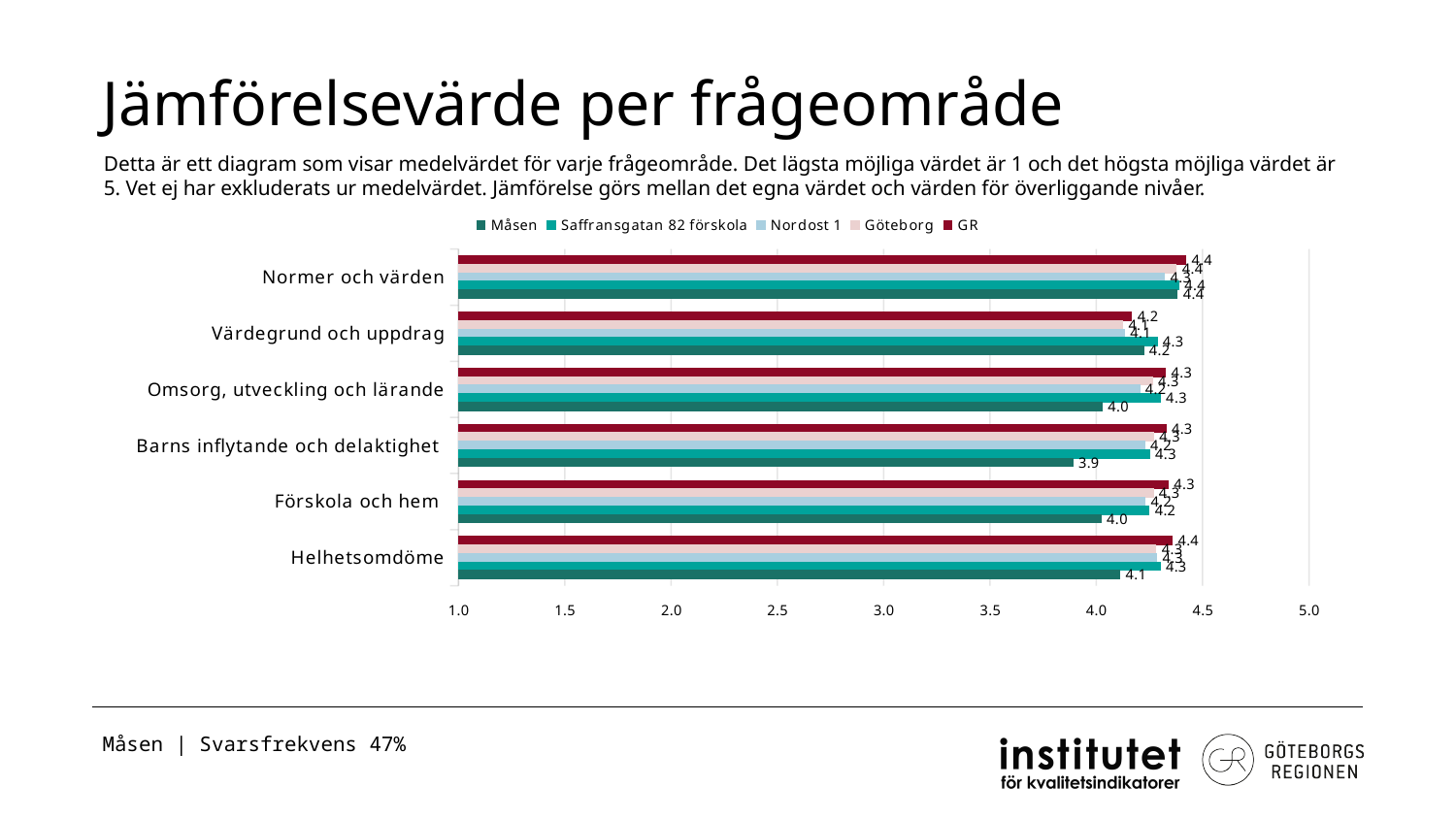
What is the value for Måsen in 'Barns inflytande och delaktighet'? 3.9 Which is larger for 'Omsorg, utveckling och lärande': the value for Måsen or the value for Saffransgatan 82 förskola? Saffransgatan 82 förskola Which series is shown in dark red in the legend? GR How many question areas (categories) are shown on the y axis? 6 Is the value for Måsen in 'Barns inflytande och delaktighet' greater or less than 4.0? less What is the difference between Saffransgatan 82 förskola and Måsen in 'Barns inflytande och delaktighet'? 0.4 What type of chart is shown on the slide? bar chart How many series does the legend list? 5 What is the value for Måsen in 'Normer och värden'? 4.4 In which question area does Måsen have its lowest value? Barns inflytande och delaktighet What is the value for Saffransgatan 82 förskola in 'Barns inflytande och delaktighet'? 4.3 What is the value for Måsen in 'Helhetsomdöme'? 4.1